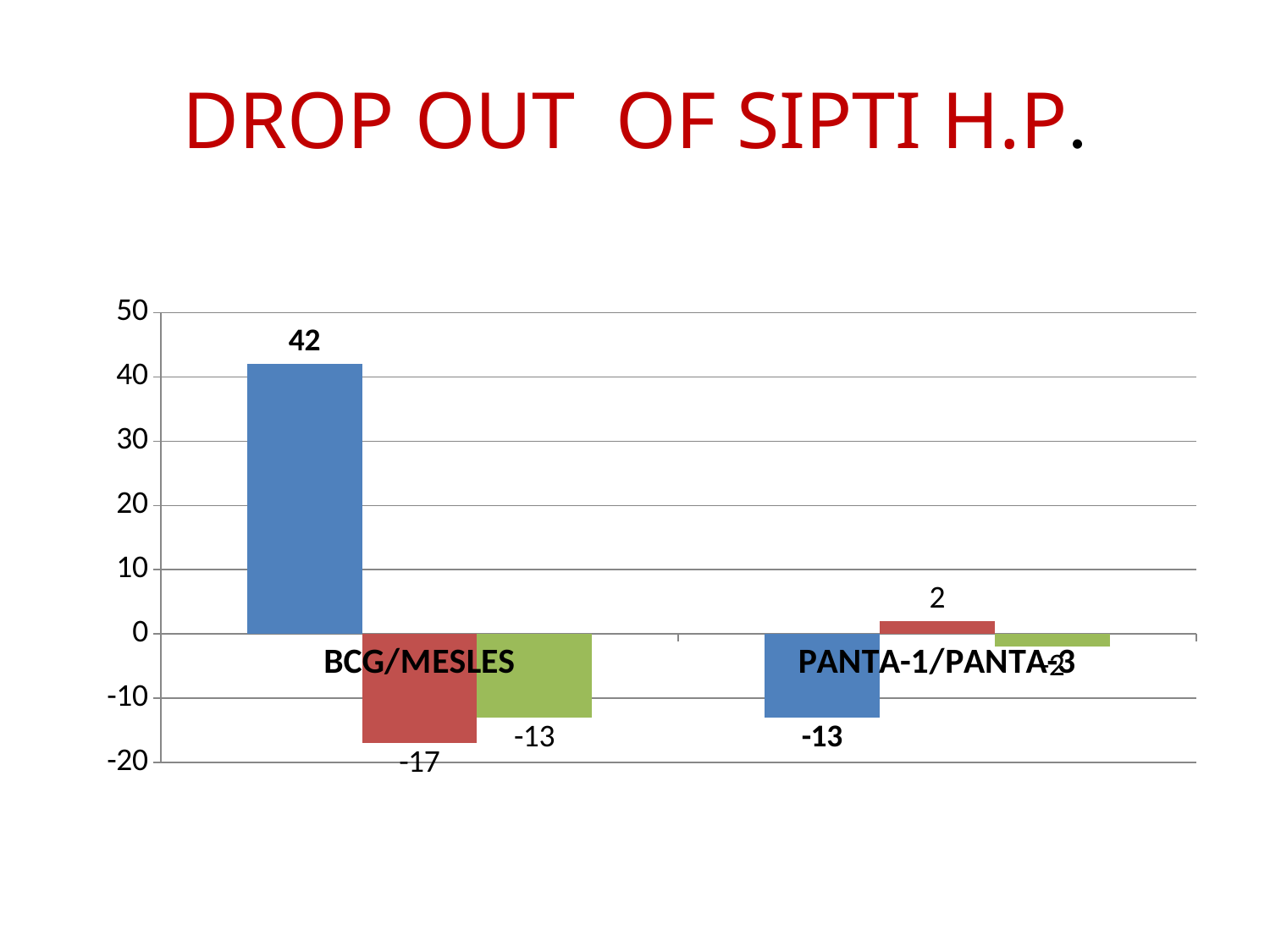
What is the value of the red bar for PANTA-1/PANTA-3? 2 What type of chart is shown on the slide? bar chart How many categories are shown on the x axis of the chart? 2 What is the value of the red bar for BCG/MESLES? -17 What is the title of the chart on the slide? DROP OUT OF SIPTI H.P. Which bar has the lowest value in the chart? the red bar for BCG/MESLES What is the value of the blue bar for BCG/MESLES? 42 Which bar has the highest value in the chart? the blue bar for BCG/MESLES What is the value of the blue bar for PANTA-1/PANTA-3? -13 What is the value of the green bar for BCG/MESLES? -13 Which is larger, the red bar for BCG/MESLES or the red bar for PANTA-1/PANTA-3? the red bar for PANTA-1/PANTA-3 What is the difference between the blue bar for BCG/MESLES and the red bar for BCG/MESLES? 59